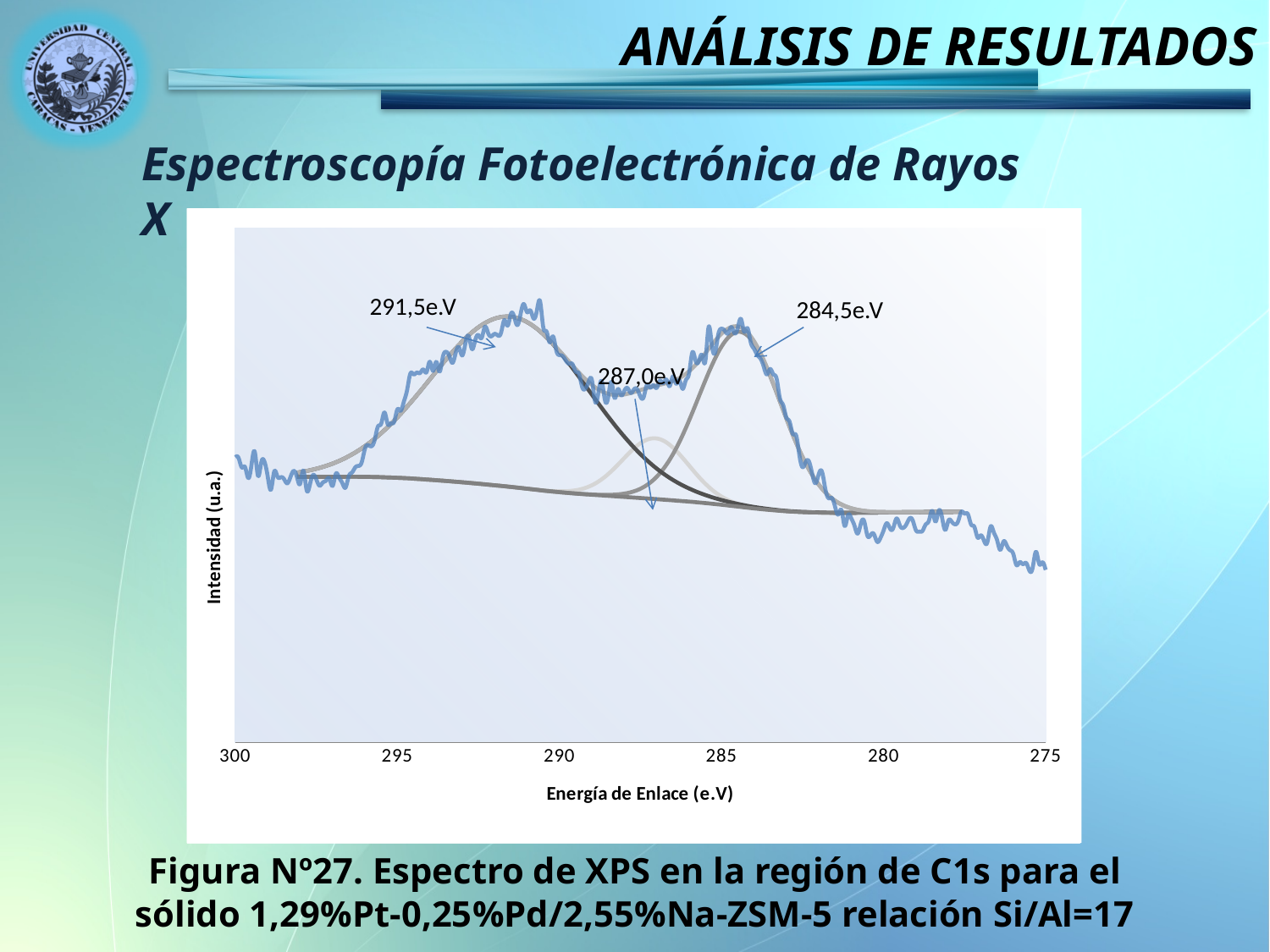
What binding energy is annotated for the leftmost peak of the spectrum? 291,5e.V How many peaks are annotated with a binding energy value on the chart? 3 Which annotated peak has the highest binding energy? 291,5e.V What binding energy is annotated for the rightmost peak of the spectrum? 284,5e.V What is the label of the x axis of the chart? Energía de Enlace (e.V) What is the label of the y axis of the chart? Intensidad (u.a.) What binding energy is annotated for the small middle peak of the spectrum? 287,0e.V What is the difference in binding energy between the peaks annotated 291,5e.V and 284,5e.V? 7,0 e.V What are the minimum and maximum values shown on the x axis of the chart? 275 and 300 Which of the annotated fitted peaks has the lowest intensity? 287,0e.V Which annotated peak has the lowest binding energy? 284,5e.V What kind of chart is shown on the slide? line chart